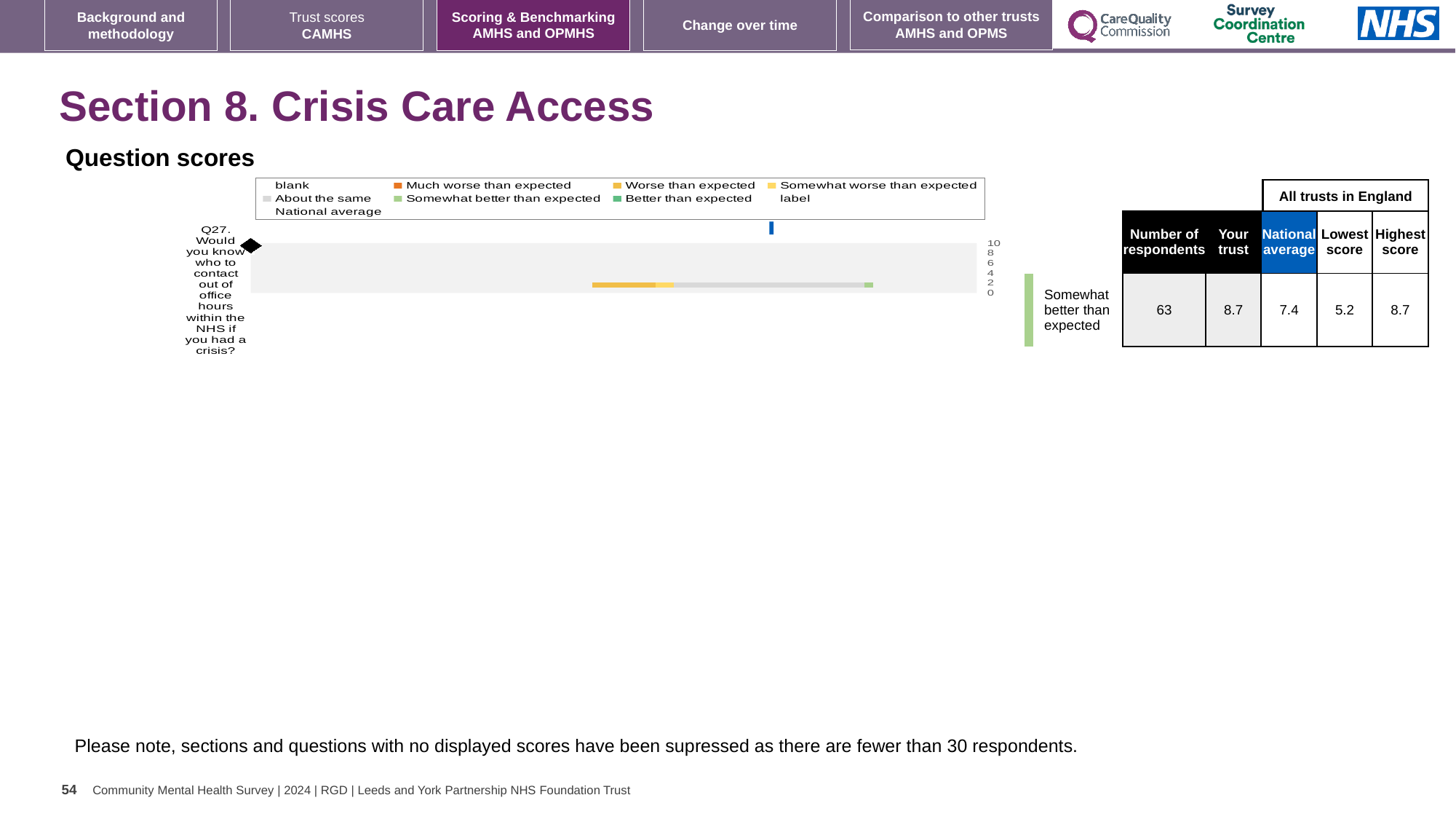
What is the National average score for Q27 shown on the slide? 7.4 What is the difference between the 'Your trust' score and the National average for Q27? 1.3 What is the 'Your trust' score for Q27 shown on the slide? 8.7 What kind of chart is shown under 'Question scores'? bar chart What is the Highest score among all trusts in England for Q27? 8.7 What benchmark category is the trust's Q27 score assigned to on the slide? Somewhat better than expected How many questions (categories) are plotted in the Question scores chart? 1 Which question is plotted in the Question scores chart? Q27. Would you know who to contact out of office hours within the NHS if you had a crisis? How many respondents answered Q27? 63 What is the Lowest score among all trusts in England for Q27? 5.2 What is the difference between the Highest score and the Lowest score for Q27 across all trusts in England? 3.5 Which is larger for Q27, the 'Your trust' score or the National average? Your trust